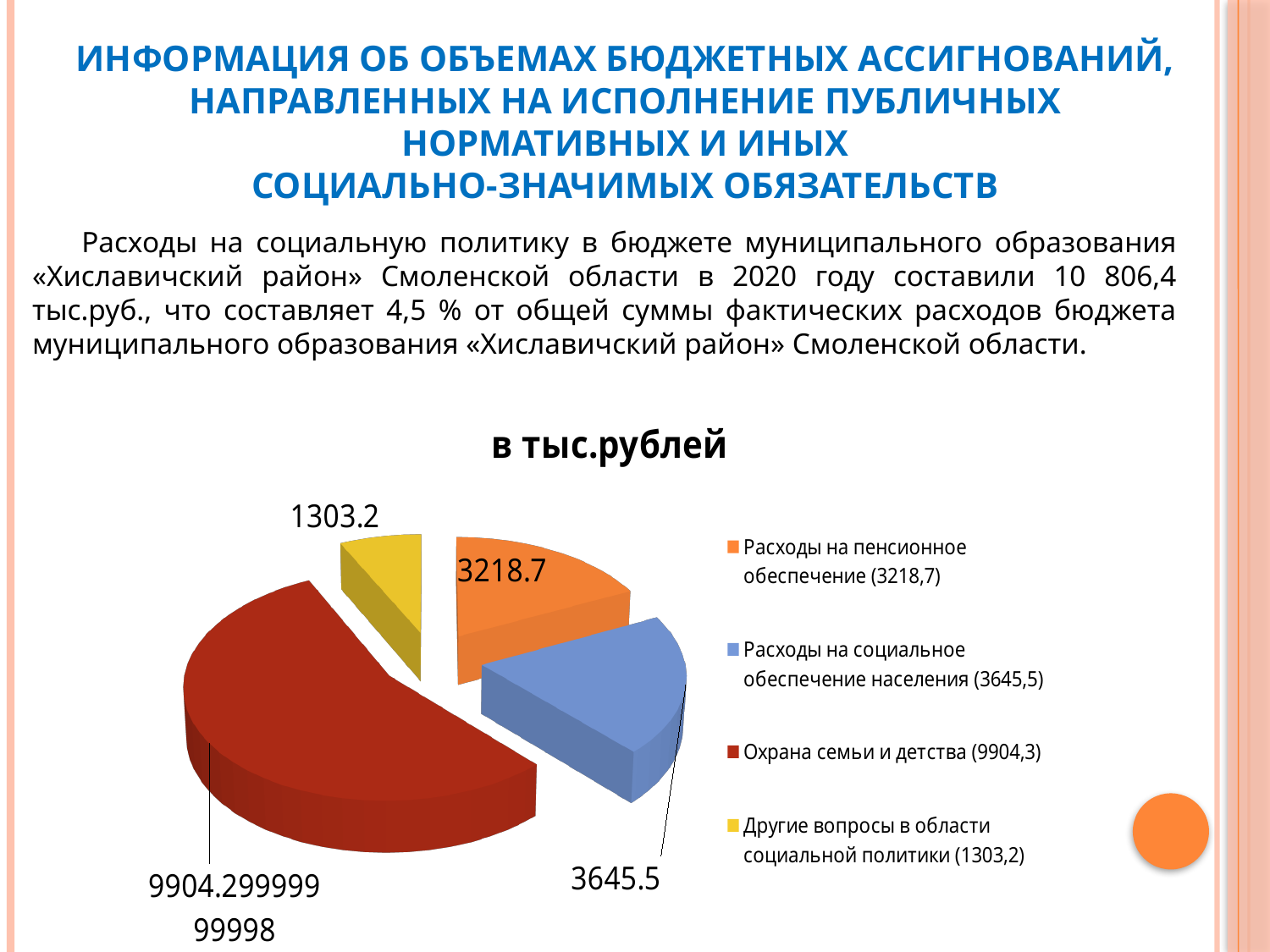
What colour is the slice for Охрана семьи и детства? red What is the difference between the values for Расходы на социальное обеспечение населения and Расходы на пенсионное обеспечение? 426,8 What value is shown for Охрана семьи и детства in the legend? 9904,3 Which category has the largest slice of the pie? Охрана семьи и детства Which category has the smallest slice of the pie? Другие вопросы в области социальной политики What is the title of the pie chart? в тыс.рублей How many slices does the pie chart have? 4 Which is larger: Расходы на пенсионное обеспечение or Расходы на социальное обеспечение населения? Расходы на социальное обеспечение населения What value is shown for Расходы на социальное обеспечение населения in the legend? 3645,5 What value is shown for Расходы на пенсионное обеспечение in the legend? 3218,7 What value is shown for Другие вопросы в области социальной политики in the legend? 1303,2 What type of chart is shown on the slide? pie chart